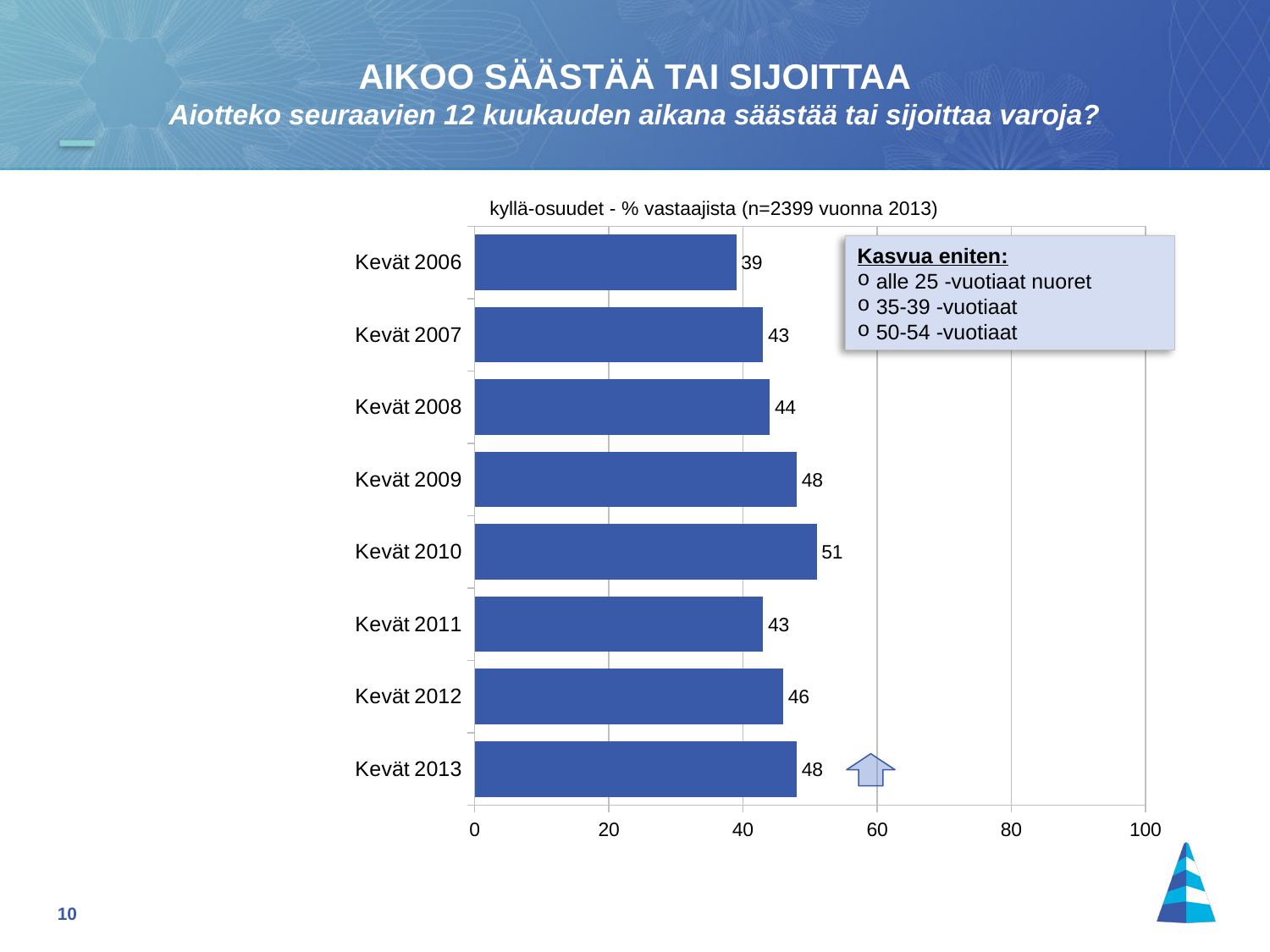
What is the chart's title? kyllä-osuudet - % vastaajista (n=2399 vuonna 2013) Which category has the lowest value? Kevät 2006 What is the value for Kevät 2006? 39 What is the difference between the values for Kevät 2013 and Kevät 2012? 2 What is the value for Kevät 2013? 48 Which is larger, the value for Kevät 2009 or the value for Kevät 2011? Kevät 2009 Which category has the highest value? Kevät 2010 What kind of chart is shown on the slide? bar chart How many categories are shown on the chart? 8 Is the value for Kevät 2010 greater or less than 40? greater What is the difference between the values for Kevät 2010 and Kevät 2006? 12 What is the value for Kevät 2010? 51